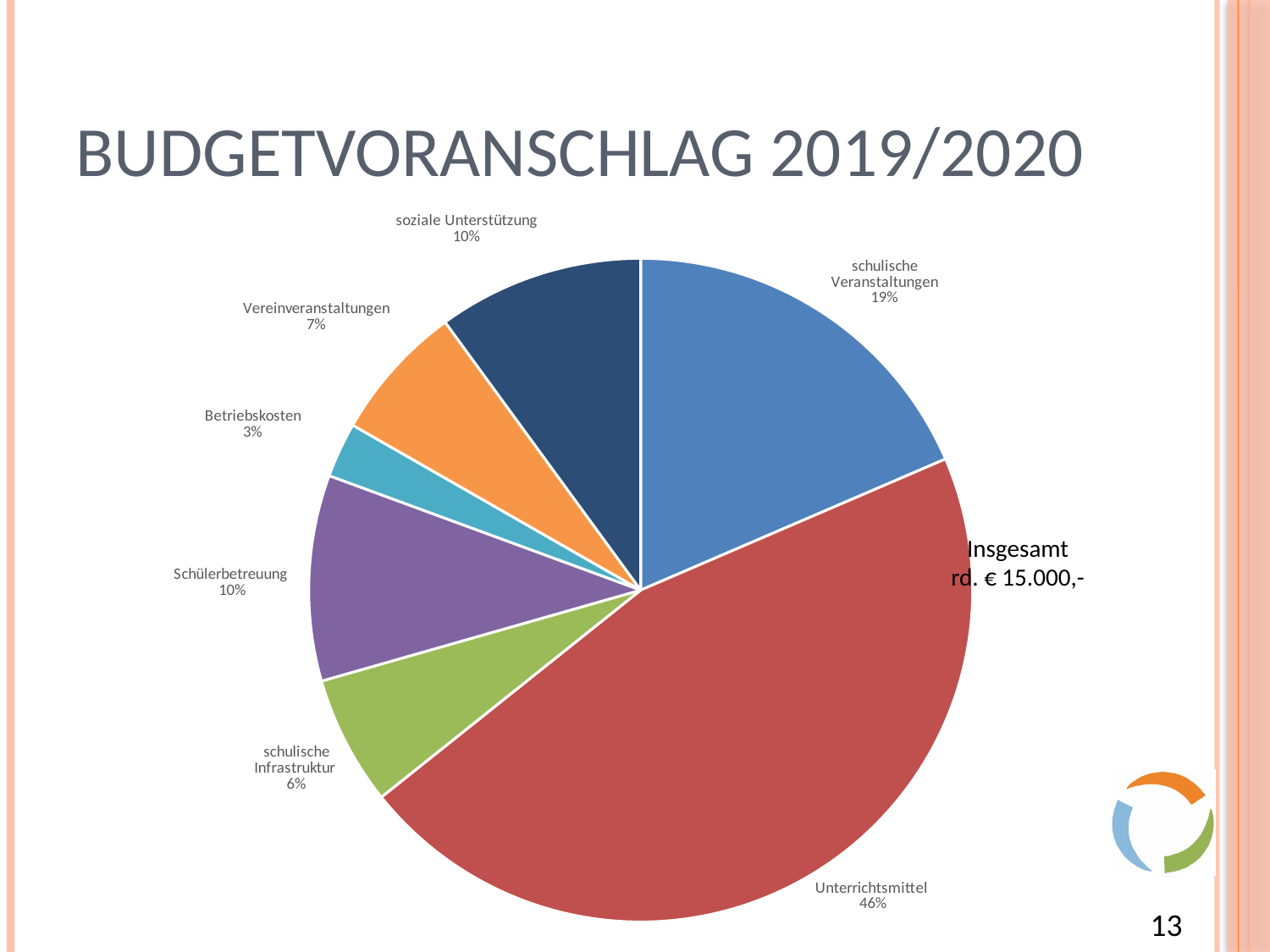
What percentage is shown for Betriebskosten? 3% Which category has the smallest slice of the pie? Betriebskosten What share of the budget goes to schulische Veranstaltungen? 19% Which is larger, the share for Schülerbetreuung or the share for schulische Infrastruktur? Schülerbetreuung What percentage is shown for schulische Infrastruktur? 6% Which category has the largest slice of the pie? Unterrichtsmittel What percentage is shown for Vereinveranstaltungen? 7% What share of the budget goes to Unterrichtsmittel? 46% How many slices does the pie chart have? 7 What is the difference in percentage points between Unterrichtsmittel and schulische Veranstaltungen? 27 What kind of chart is shown on the slide? pie chart What is the title of the slide containing the pie chart? BUDGETVORANSCHLAG 2019/2020